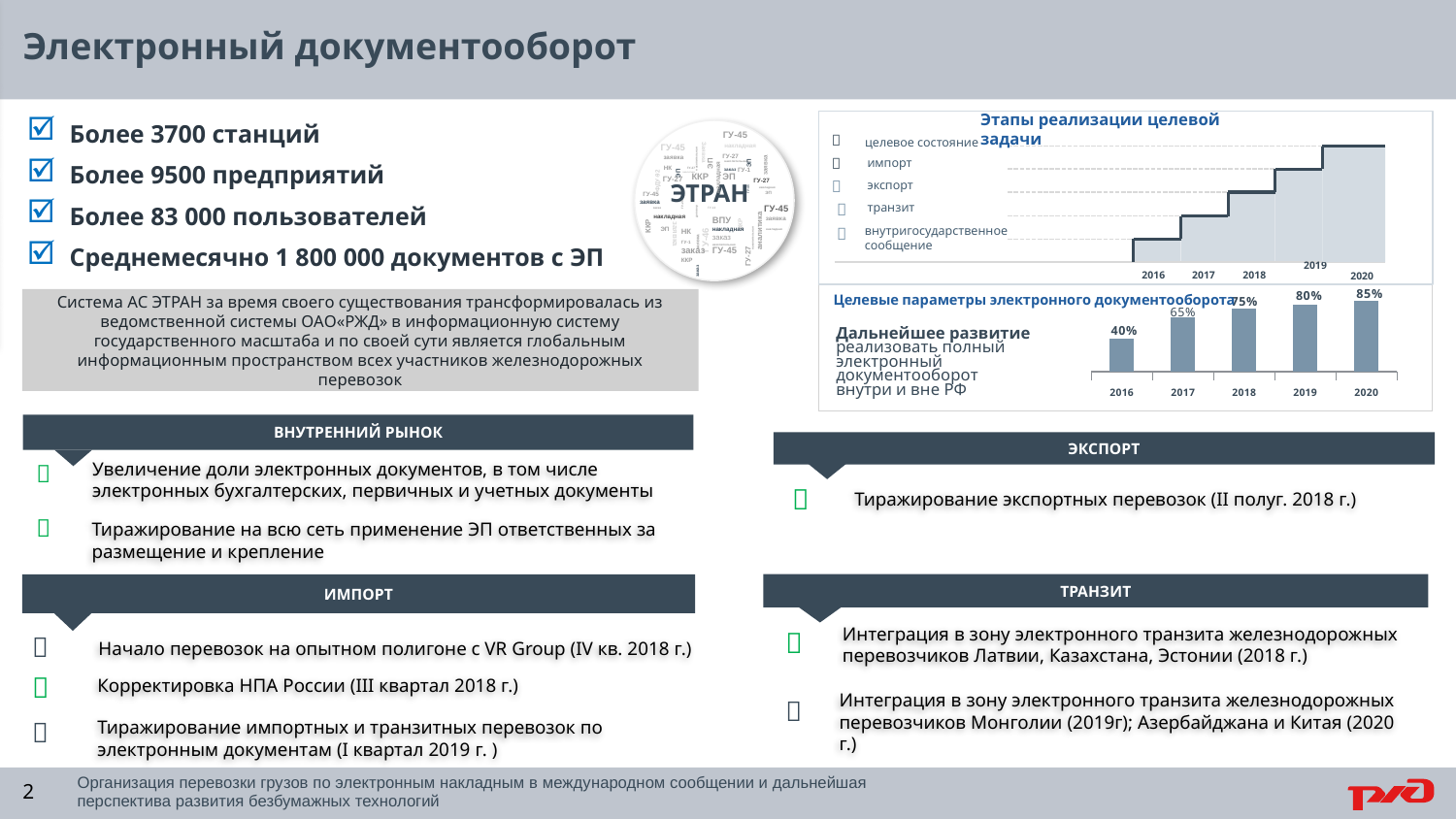
In the bar chart 'Целевые параметры электронного документооборота', do the values rise or fall from 2016 to 2020? rise In the bar chart 'Целевые параметры электронного документооборота', what is the value for 2016? 40% In the bar chart 'Целевые параметры электронного документооборота', what is the difference between the values for 2020 and 2016? 45% In the bar chart 'Целевые параметры электронного документооборота', which year has the lowest value? 2016 In the bar chart 'Целевые параметры электронного документооборота', what is the difference between the values for 2017 and 2016? 25% In the bar chart 'Целевые параметры электронного документооборота', what is the value for 2017? 65% What kind of chart is 'Целевые параметры электронного документооборота'? bar chart In the bar chart 'Целевые параметры электронного документооборота', what is the value for 2020? 85% In the bar chart 'Целевые параметры электронного документооборота', which is larger, the value for 2018 or the value for 2016? 2018 In the bar chart 'Целевые параметры электронного документооборота', which year has the highest value? 2020 In the bar chart 'Целевые параметры электронного документооборота', what is the value for 2019? 80% How many years are shown in the bar chart 'Целевые параметры электронного документооборота'? 5